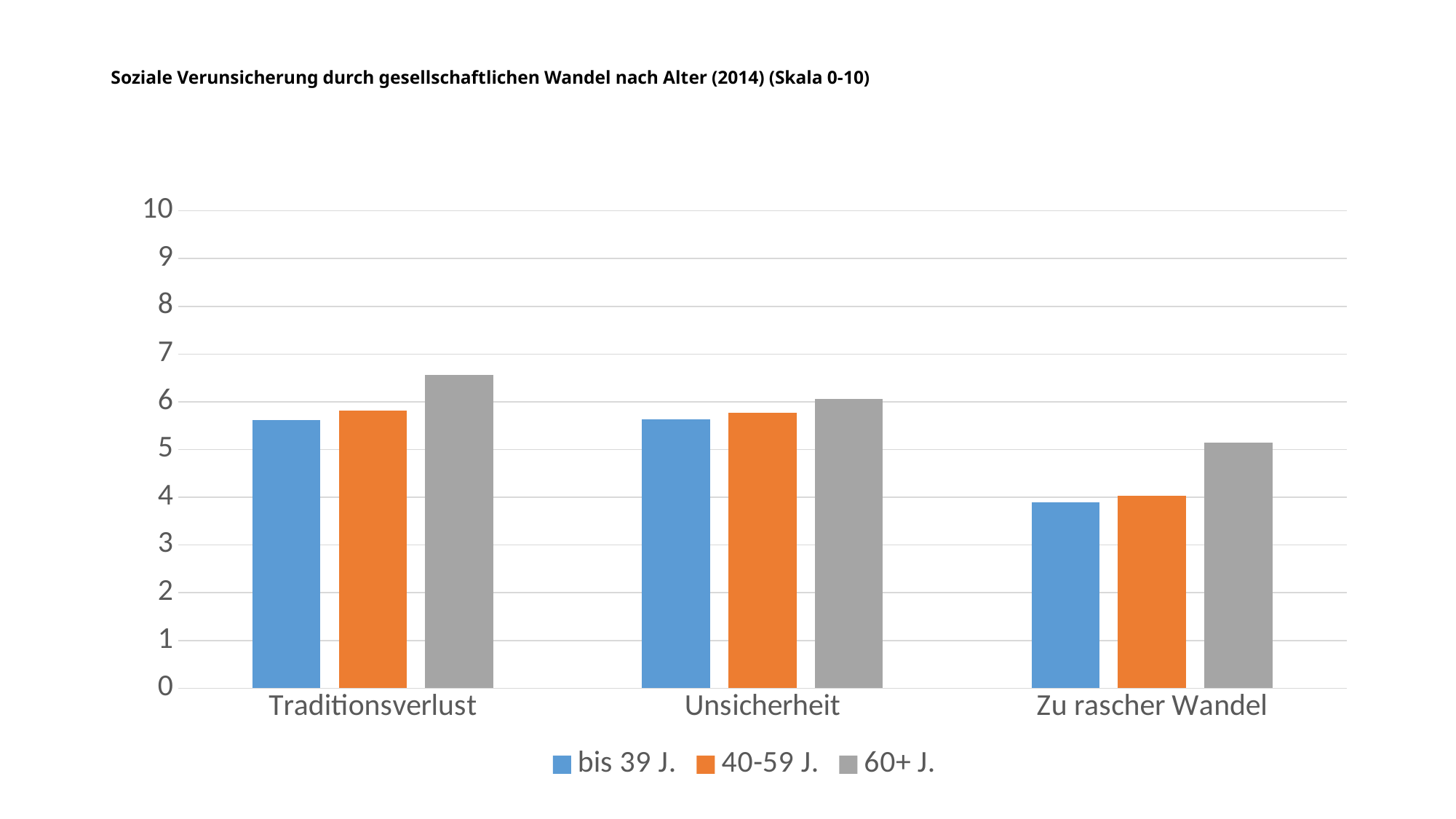
Do the values for the 60+ J. series rise or fall from Traditionsverlust to Zu rascher Wandel? fall Which is larger: the 40-59 J. value for Traditionsverlust or the 40-59 J. value for Zu rascher Wandel? Traditionsverlust Is the value for 60+ J. in Traditionsverlust greater or less than 6? greater For the 60+ J. series, which category has the highest value? Traditionsverlust For the 60+ J. series, which category has the lowest value? Zu rascher Wandel How many categories are shown on the x axis? 3 What kind of chart is shown on the slide? bar chart Is the value for bis 39 J. in Traditionsverlust greater or less than 6? less How many series does the legend list? 3 Which age group has the highest bar for Traditionsverlust? 60+ J. Which age group has the highest bar for Zu rascher Wandel? 60+ J. Is the value for 40-59 J. in Unsicherheit greater or less than 5? greater